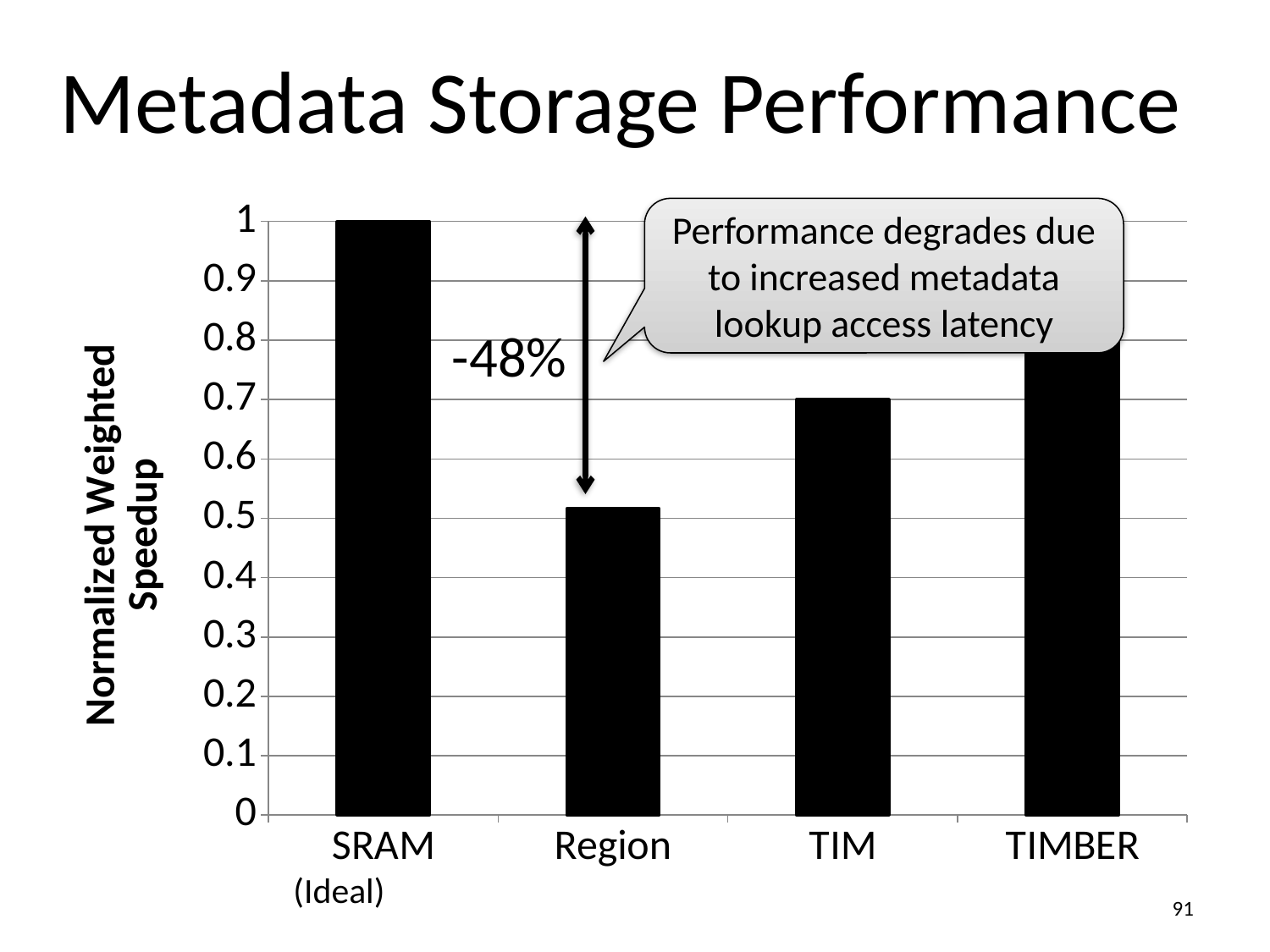
Is the value for TIMBER greater or less than 0.7? greater What kind of chart is shown on the slide? bar chart Which category has the lowest Normalized Weighted Speedup? Region What percentage change is annotated between the SRAM (Ideal) bar and the Region bar? -48% What is the Normalized Weighted Speedup for SRAM (Ideal)? 1 Which has a higher Normalized Weighted Speedup, TIMBER or TIM? TIMBER Is the value for TIM greater or less than 0.6? greater Which category has the highest Normalized Weighted Speedup? SRAM (Ideal) How many categories are shown on the x axis? 4 Which has a higher Normalized Weighted Speedup, TIM or Region? TIM Is the value for Region greater or less than 0.6? less